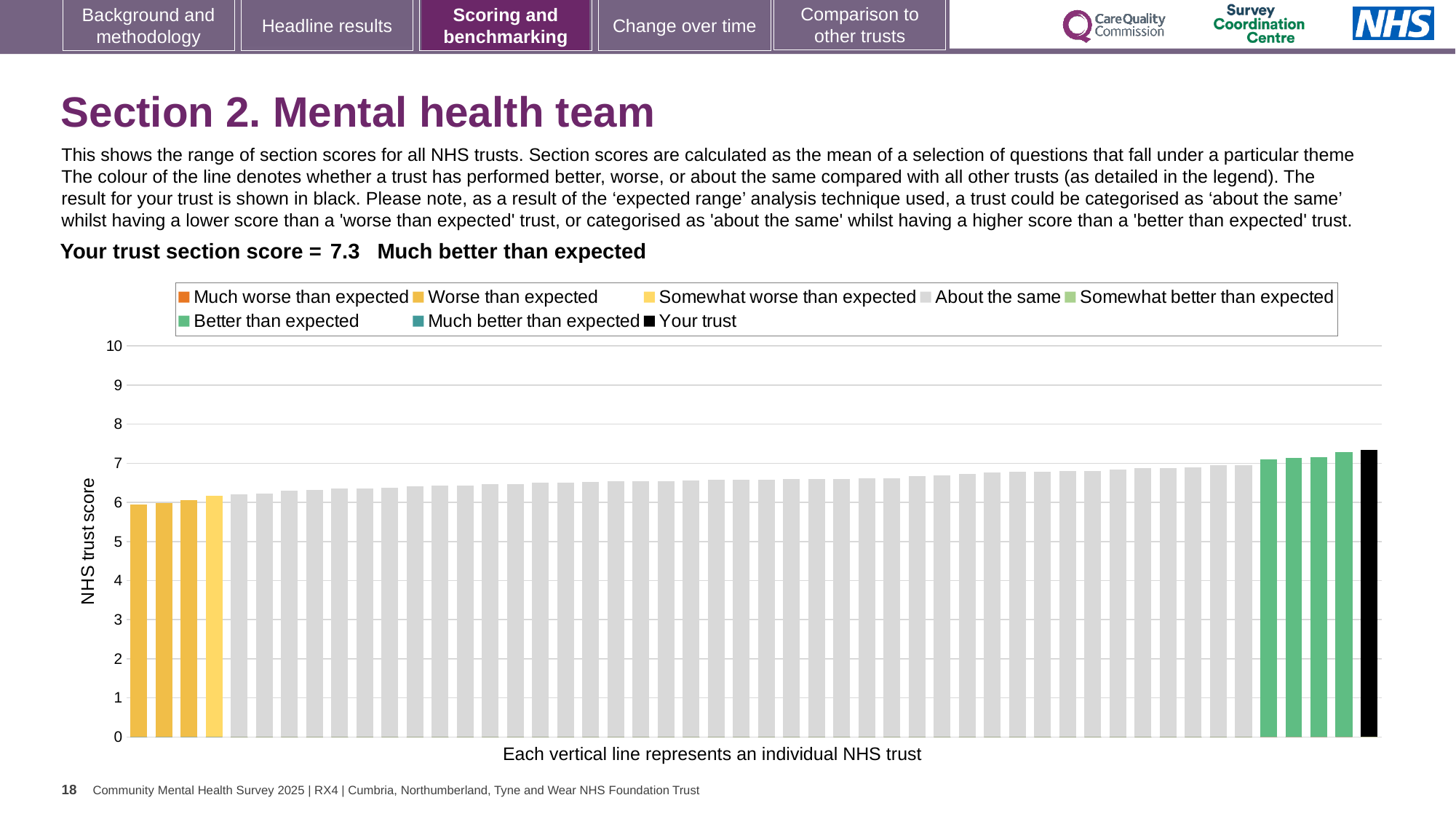
Is the value of the leftmost bar greater or less than 5? greater What is the section score for your trust shown on the slide? 7.3 Is the value of the black bar (your trust) greater or less than 7? greater How many bars are coloured green? 4 How many entries does the chart legend list? 8 Which performance category is your trust's section score given as? Much better than expected What kind of chart is shown on the slide? bar chart What is the label of the y axis? NHS trust score Do the bar values rise or fall from left to right along the x axis? rise What is the highest value shown on the y axis? 10 Is the value of the leftmost bar greater or less than 7? less